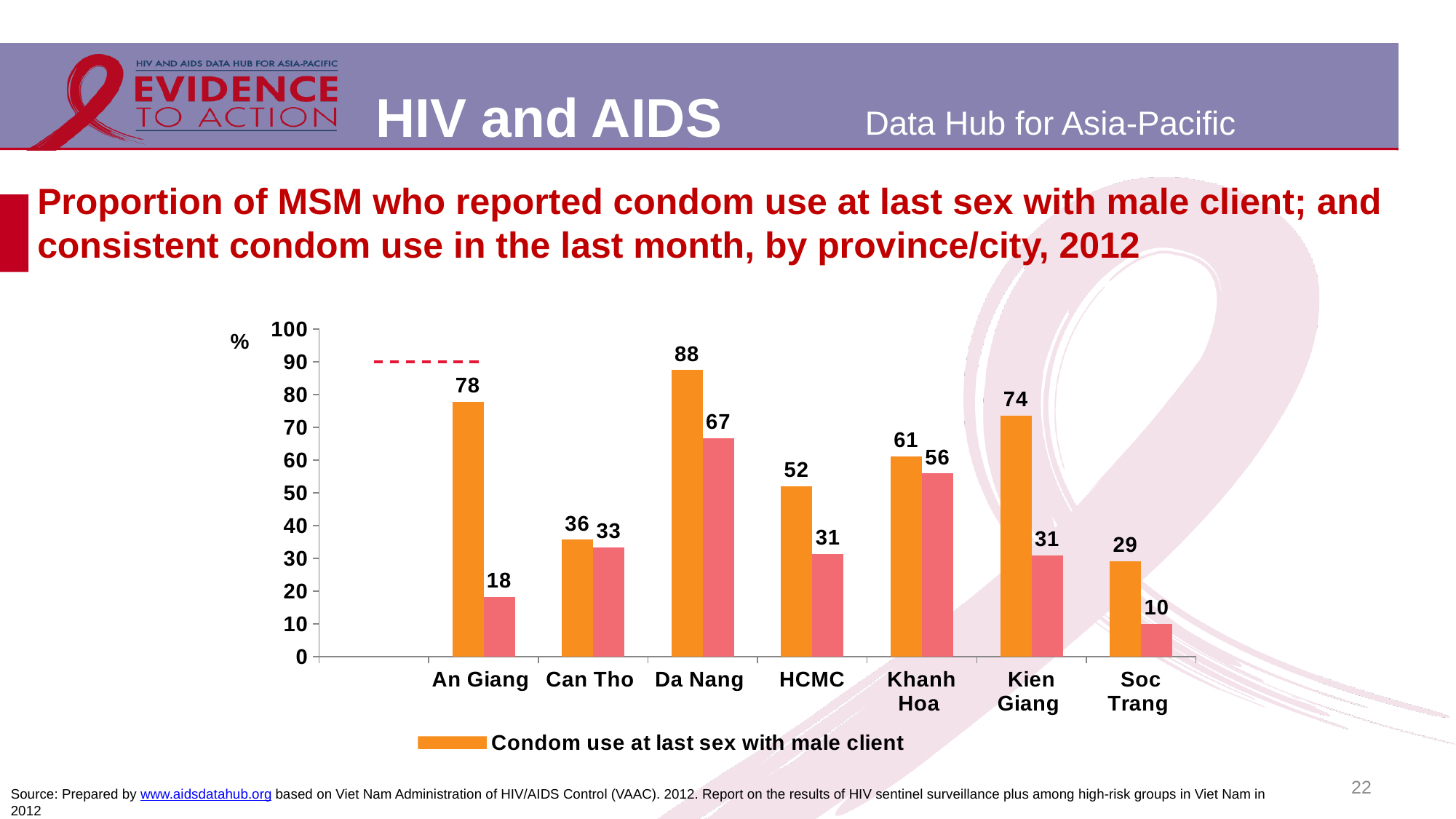
Which has a higher value for condom use at last sex with male client, Kien Giang or Khanh Hoa? Kien Giang Which province/city has the lowest value for condom use at last sex with male client? Soc Trang Which province/city has the highest value for condom use at last sex with male client? Da Nang What is the value for Da Nang for condom use at last sex with male client? 88 What series label is shown in the legend? Condom use at last sex with male client What is the difference between the orange and pink bars for Da Nang? 21 What kind of chart is shown on the slide? Bar chart What is the difference between the orange and pink bars for An Giang? 60 What is the value of the pink bar (consistent condom use in the last month) for An Giang? 18 What is the value of the pink bar for Khanh Hoa? 56 How many provinces/cities are shown on the x axis? 7 Which province/city has the lowest value among the pink bars? Soc Trang